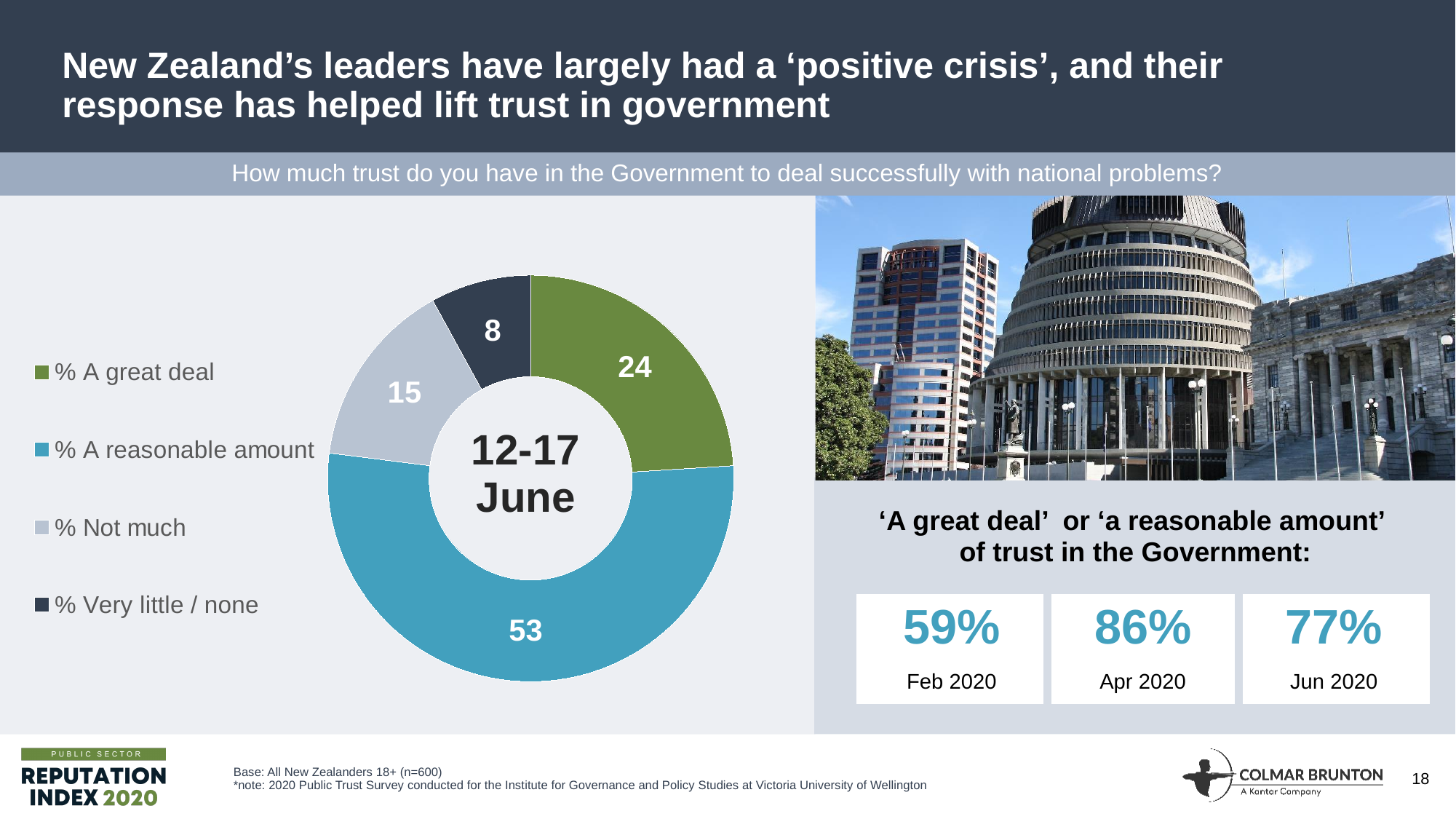
What value is shown for '% Not much'? 15 What colour is the slice for '% A great deal'? Green What value is shown for '% A reasonable amount'? 53 What kind of chart is shown on the slide? Doughnut (pie) chart Which category has the largest slice? % A reasonable amount What is the difference between the values for '% A reasonable amount' and '% A great deal'? 29 What value is shown for '% Very little / none'? 8 What text is shown in the centre of the doughnut chart? 12-17 June How many categories does the legend list? 4 What value is shown for '% A great deal'? 24 Which is larger, the value for '% Not much' or the value for '% Very little / none'? % Not much Which category has the smallest slice? % Very little / none